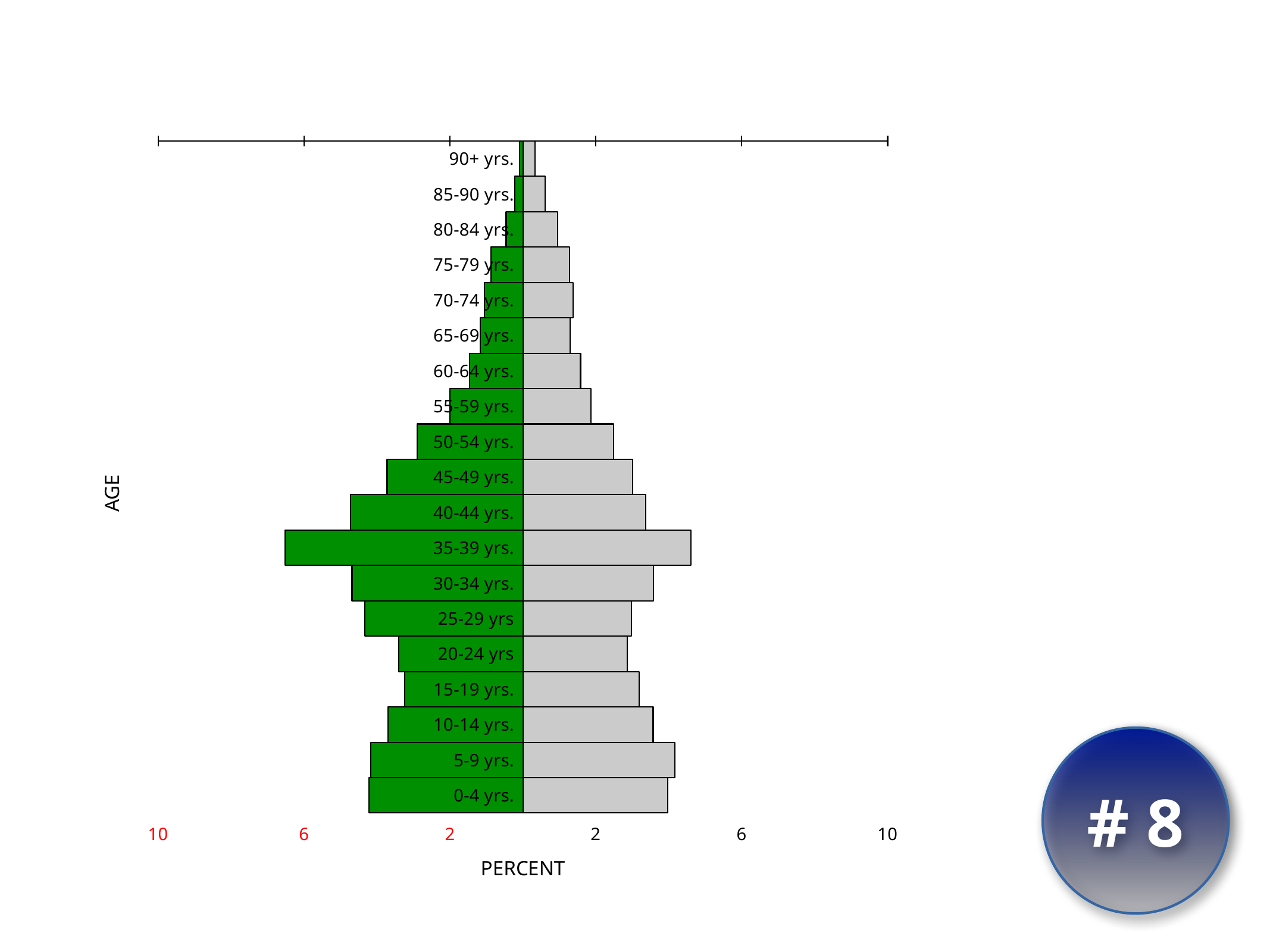
Is the grey bar for 80-84 yrs. greater or less than 2 percent? less Which age group has the shortest green bar? 90+ yrs. Is the grey bar for 35-39 yrs. greater or less than 6 percent? less Is the green bar for 35-39 yrs. greater or less than 6 percent? greater Which green bar is longer, 40-44 yrs. or 45-49 yrs.? 40-44 yrs. Which age group has the longest green bar? 35-39 yrs. Which age group has the longest grey bar? 35-39 yrs. What is the title of the horizontal axis? PERCENT What kind of chart is shown on the slide? bar chart How many age groups are plotted on the chart? 19 For the 35-39 yrs. age group, which bar is longer, the green one or the grey one? green